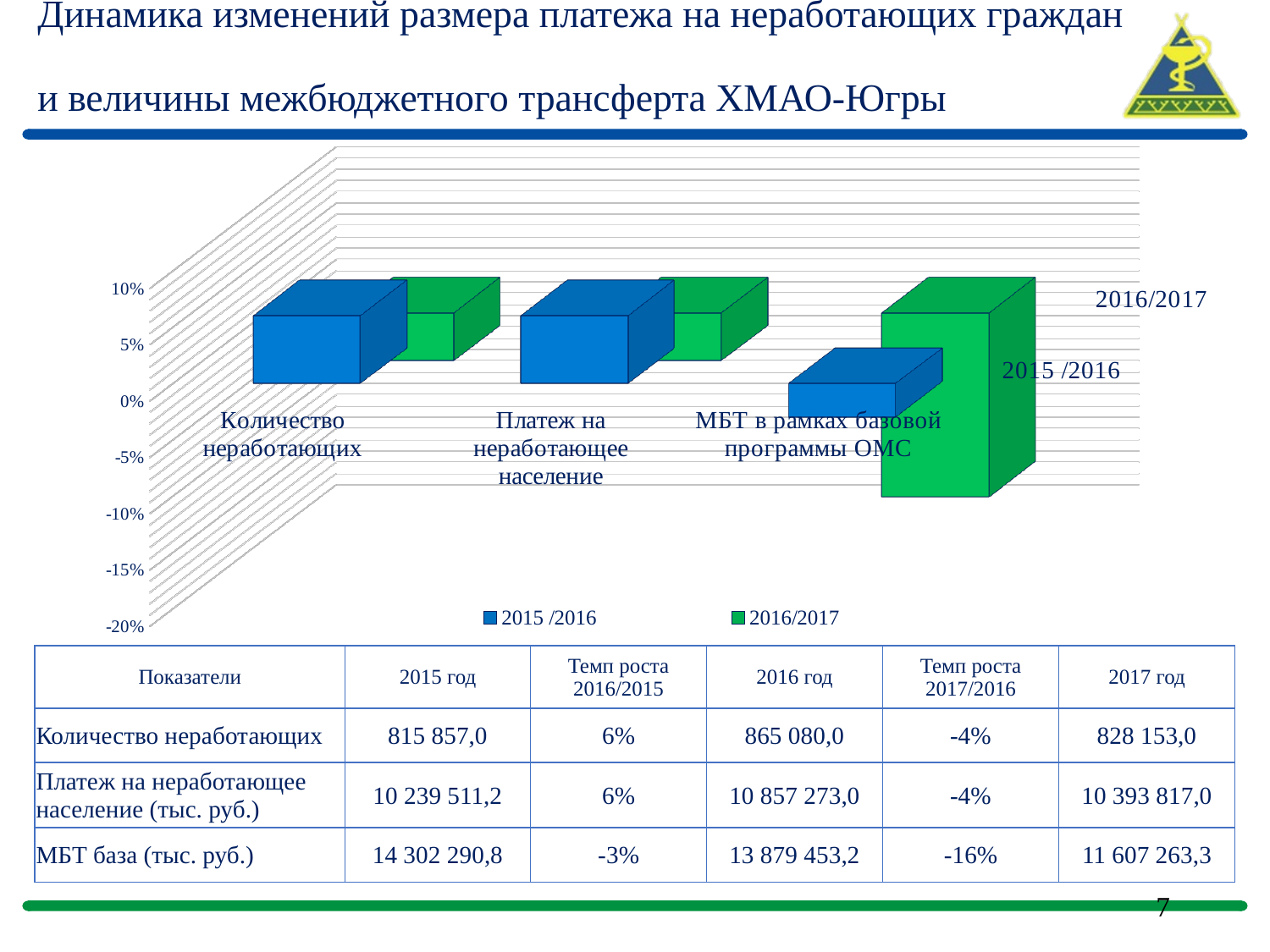
What colour represents the 2016/2017 series in the chart? green What are the two series names listed in the chart legend? 2015 /2016 and 2016/2017 How many categories are shown on the x axis of the chart? 3 Is the 2015 /2016 value for МБТ в рамках базовой программы ОМС greater or less than 5%? less Is the 2015 /2016 value for Платеж на неработающее население greater or less than 10%? less Is the 2015 /2016 value for Количество неработающих greater or less than 5%? greater How many series does the chart legend list? 2 Which category has the lowest value for the 2015 /2016 series? МБТ в рамках базовой программы ОМС What kind of chart is shown on the slide? bar chart Which category has the lowest value for the 2016/2017 series? МБТ в рамках базовой программы ОМС Which is larger: the 2015 /2016 value for Количество неработающих or the 2015 /2016 value for МБТ в рамках базовой программы ОМС? Количество неработающих